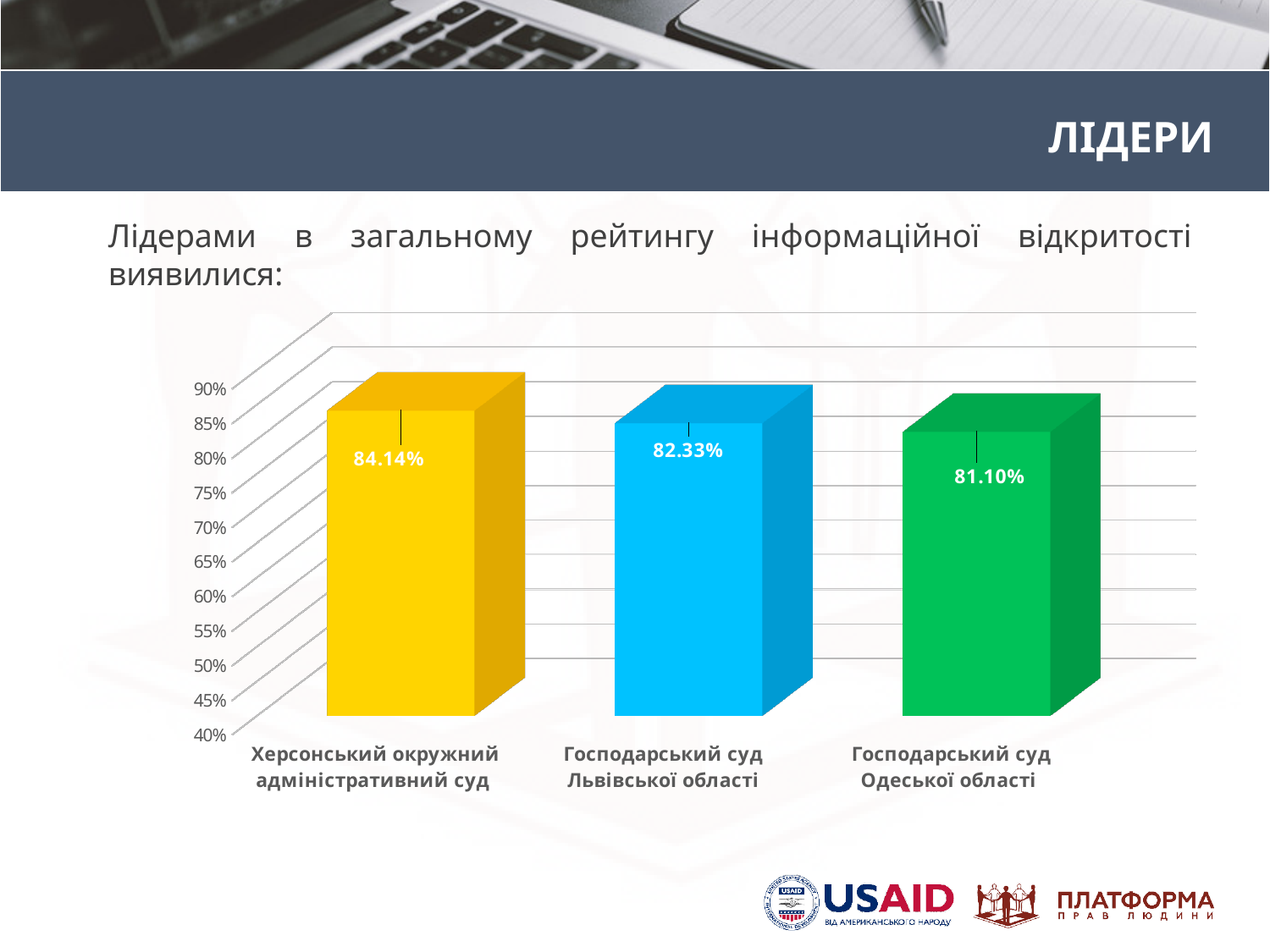
What is the value for Господарський суд Львівської області? 82.33% What is the value for Херсонський окружний адміністративний суд? 84.14% Which category has the lowest value? Господарський суд Одеської області What is the difference between the values for Господарський суд Львівської області and Господарський суд Одеської області? 1.23% Which category has the highest value? Херсонський окружний адміністративний суд Do the values rise or fall from left to right along the x axis? fall What is the value for Господарський суд Одеської області? 81.10% Which is larger, the value for Господарський суд Львівської області or the value for Господарський суд Одеської області? Господарський суд Львівської області Is the value for Господарський суд Одеської області greater or less than 85%? less How many categories are shown in the chart? 3 What is the difference between the values for Херсонський окружний адміністративний суд and Господарський суд Одеської області? 3.04% What kind of chart is shown on the slide? bar chart